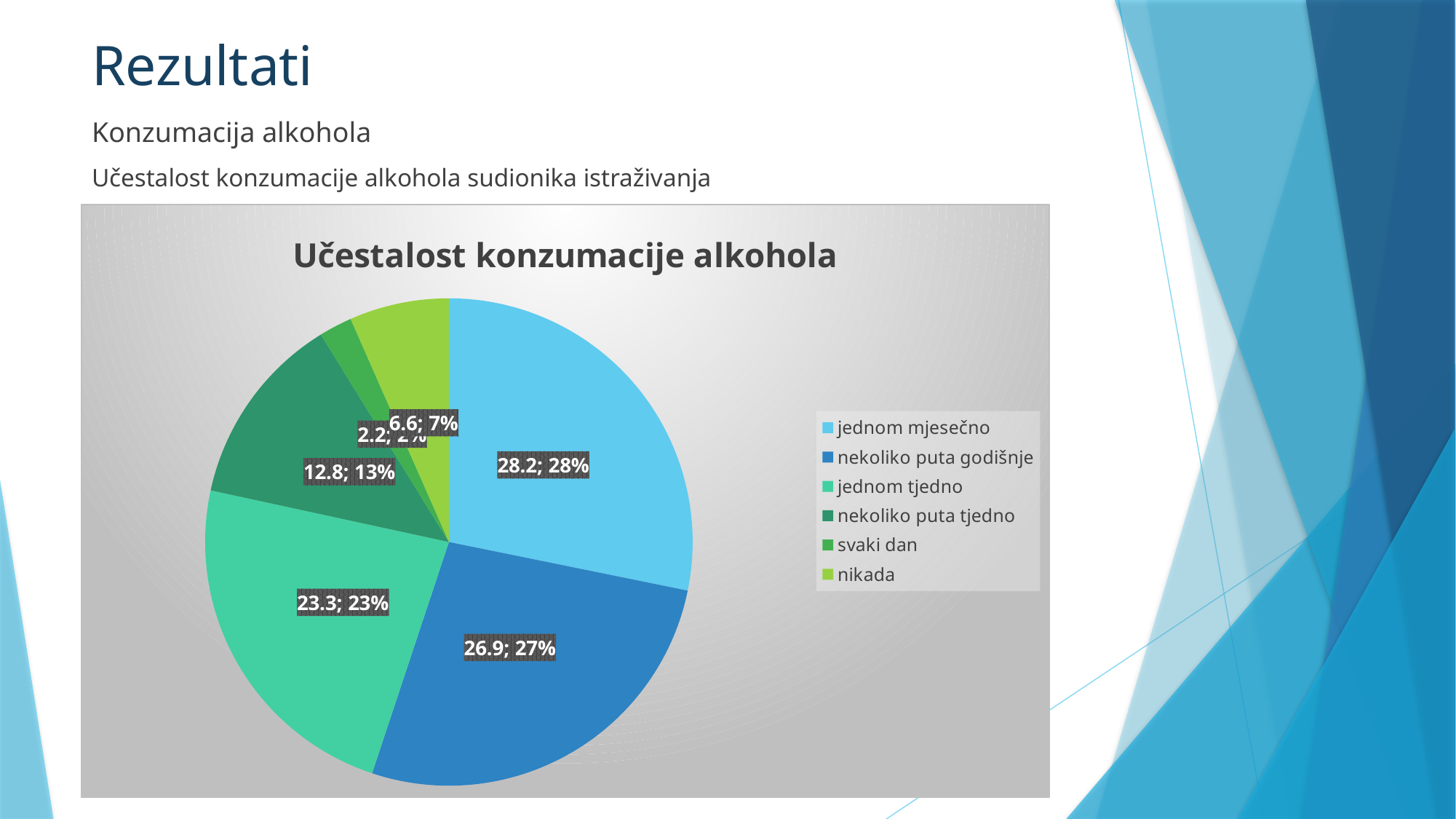
What value is shown for the 'jednom tjedno' slice? 23.3 What value is shown for the 'nikada' slice? 6.6 How many categories does the legend of the pie chart list? 6 What kind of chart is shown on the slide? pie chart What value is shown for the 'jednom mjesečno' slice? 28.2 Which category has the smallest slice of the pie? svaki dan What percentage share of the pie does 'nekoliko puta tjedno' have? 13% What value is shown for the 'nekoliko puta godišnje' slice? 26.9 What value is shown for the 'nekoliko puta tjedno' slice? 12.8 What is the title of the chart? Učestalost konzumacije alkohola What is the difference between the values for 'jednom mjesečno' and 'jednom tjedno'? 4.9 Which category has the largest slice of the pie? jednom mjesečno